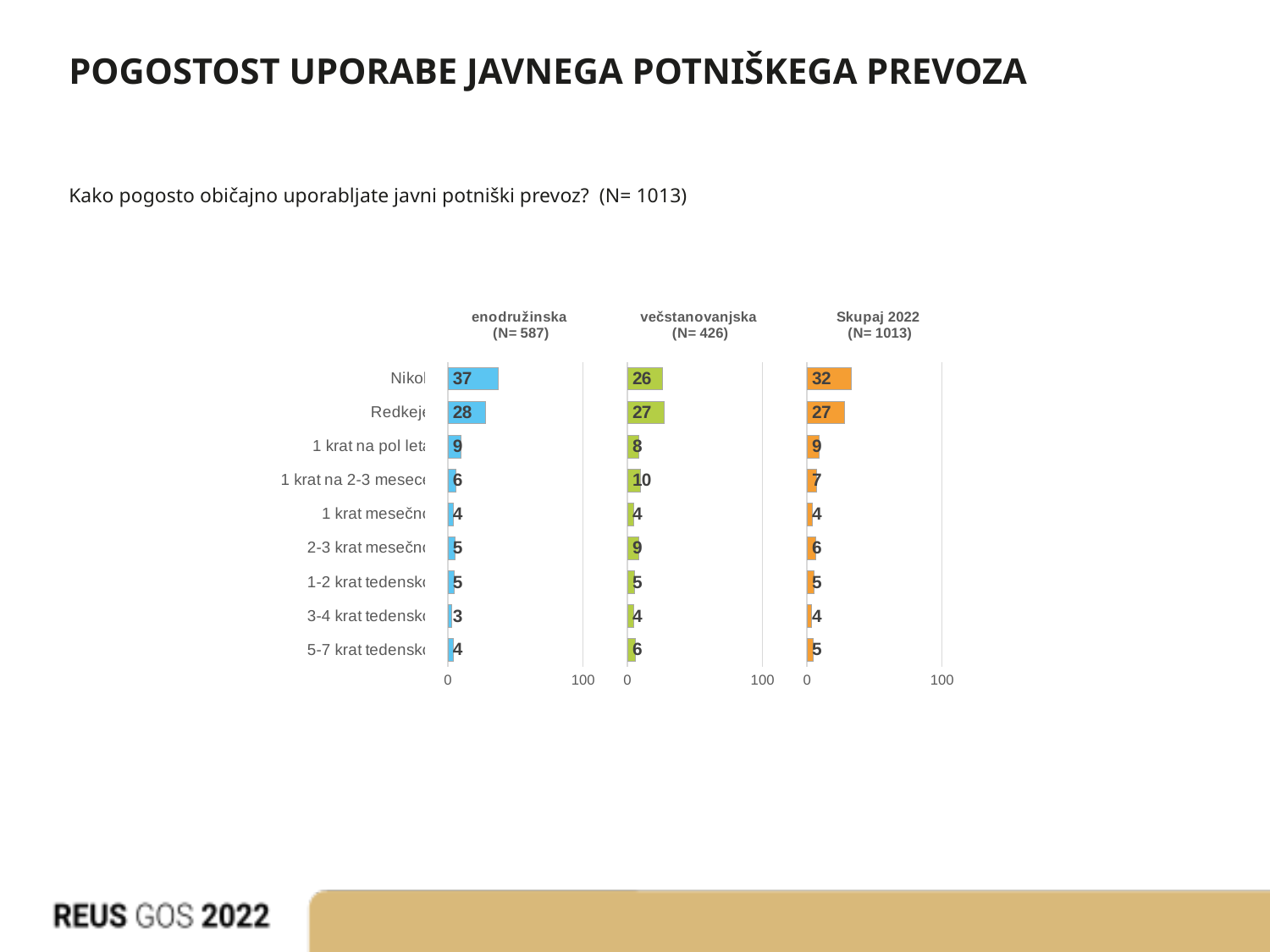
In the večstanovanjska (N= 426) chart, what is the value for 1 krat na 2-3 mesece? 10 What is the title of the slide? POGOSTOST UPORABE JAVNEGA POTNIŠKEGA PREVOZA In the enodružinska (N= 587) chart, what is the value for Nikoli? 37 In the Skupaj 2022 (N= 1013) chart, what is the difference between the values for Nikoli and Redkeje? 5 In the večstanovanjska (N= 426) chart, which category has the highest value? Redkeje In the Skupaj 2022 (N= 1013) chart, what is the value for Redkeje? 27 In the enodružinska (N= 587) chart, which is larger: the value for Nikoli or the value for Redkeje? Nikoli How many categories are shown in the Skupaj 2022 (N= 1013) chart? 9 In the enodružinska (N= 587) chart, which category has the lowest value? 3-4 krat tedensko How many charts are shown on the slide? 3 What kind of chart is the enodružinska (N= 587) chart? bar chart In the večstanovanjska (N= 426) chart, is the value for Nikoli greater or less than 100? less